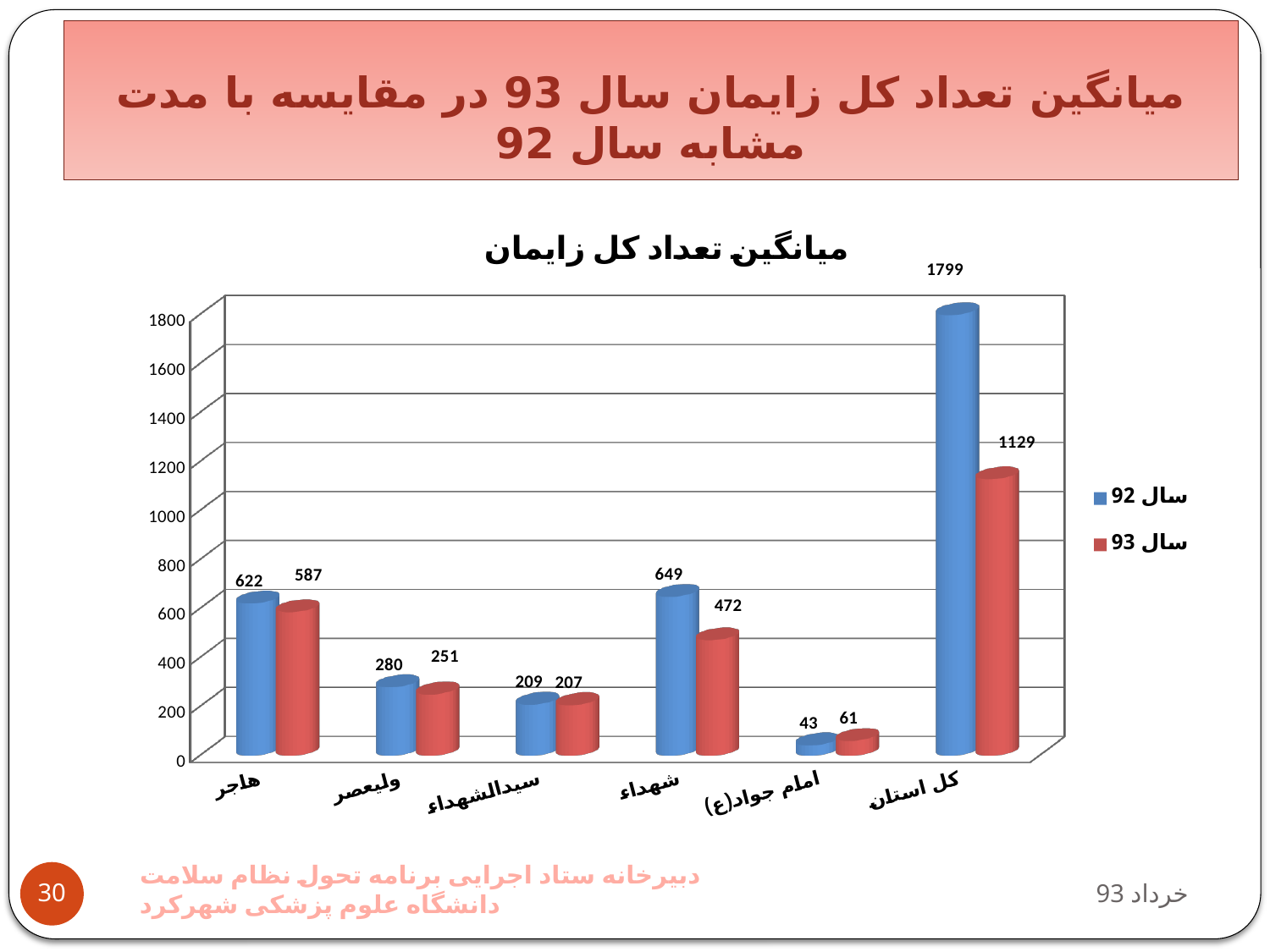
Which category has the lowest value in the سال 93 series? امام جواد(ع) What is the difference between the سال 92 and سال 93 values for کل استان? 670 What is the difference between the سال 92 and سال 93 values for شهداء? 177 What is the value for شهداء in the سال 93 series? 472 Which category has the highest value in the سال 92 series? کل استان How many series does the legend list? 2 What kind of chart is shown on the slide? bar chart What is the value for امام جواد(ع) in the سال 92 series? 43 For امام جواد(ع), which series has the larger value, سال 92 or سال 93? سال 93 What is the value for هاجر in the سال 92 series? 622 How many categories are shown on the x axis? 6 What is the title of the chart? میانگین تعداد کل زایمان